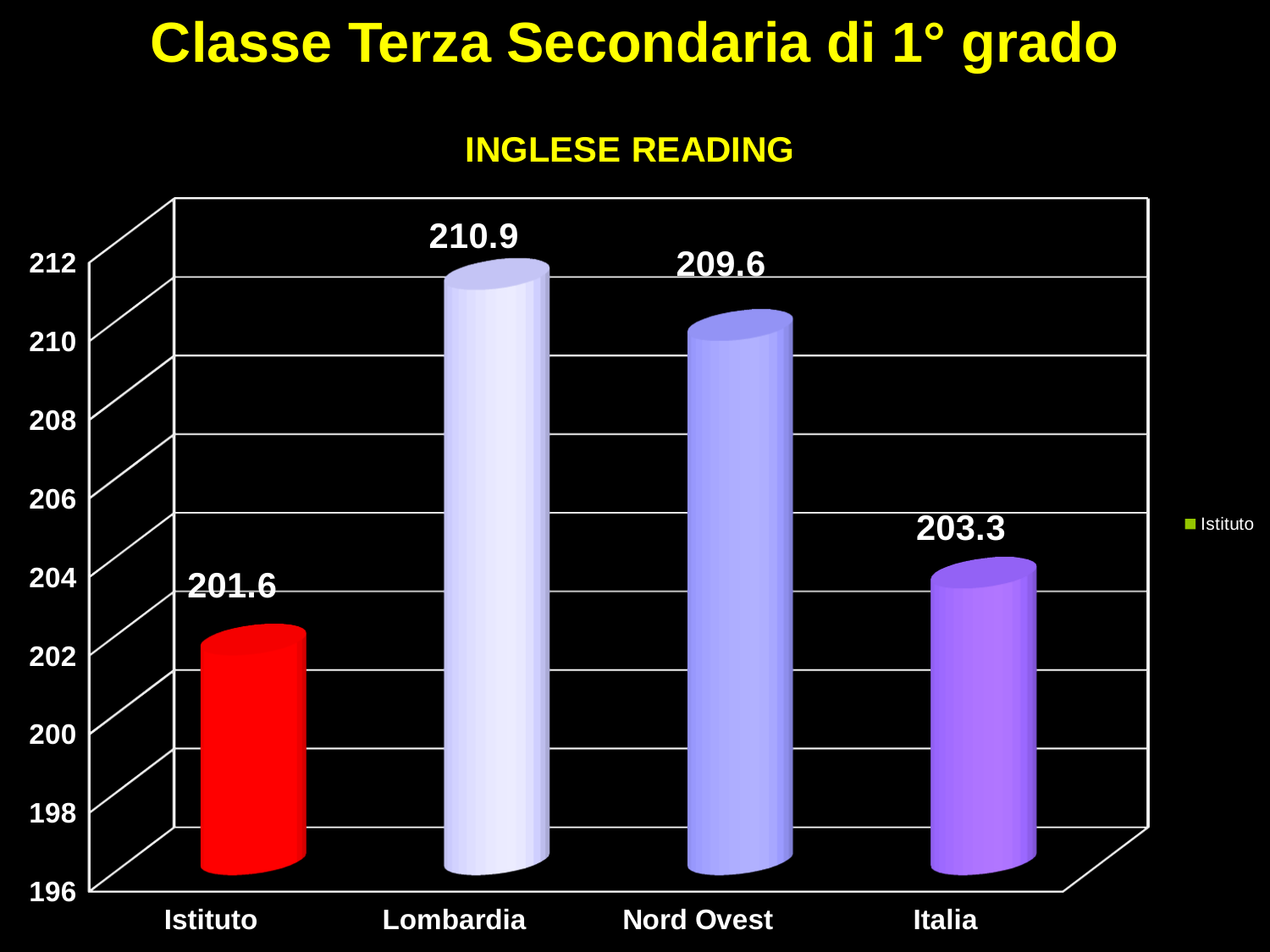
Which category has the highest value in the INGLESE READING chart? Lombardia What is the value for Nord Ovest in the INGLESE READING chart? 209.6 What is the title of the chart? INGLESE READING What is the value for Italia in the INGLESE READING chart? 203.3 Which category has the lowest value in the INGLESE READING chart? Istituto Which is larger, the value for Nord Ovest or the value for Italia? Nord Ovest What is the difference between the values for Lombardia and Istituto? 9.3 What is the value for Istituto in the INGLESE READING chart? 201.6 What kind of chart is shown on the slide? Bar chart What is the value for Lombardia in the INGLESE READING chart? 210.9 How many categories are shown on the x axis of the chart? 4 What is the difference between the values for Italia and Istituto? 1.7